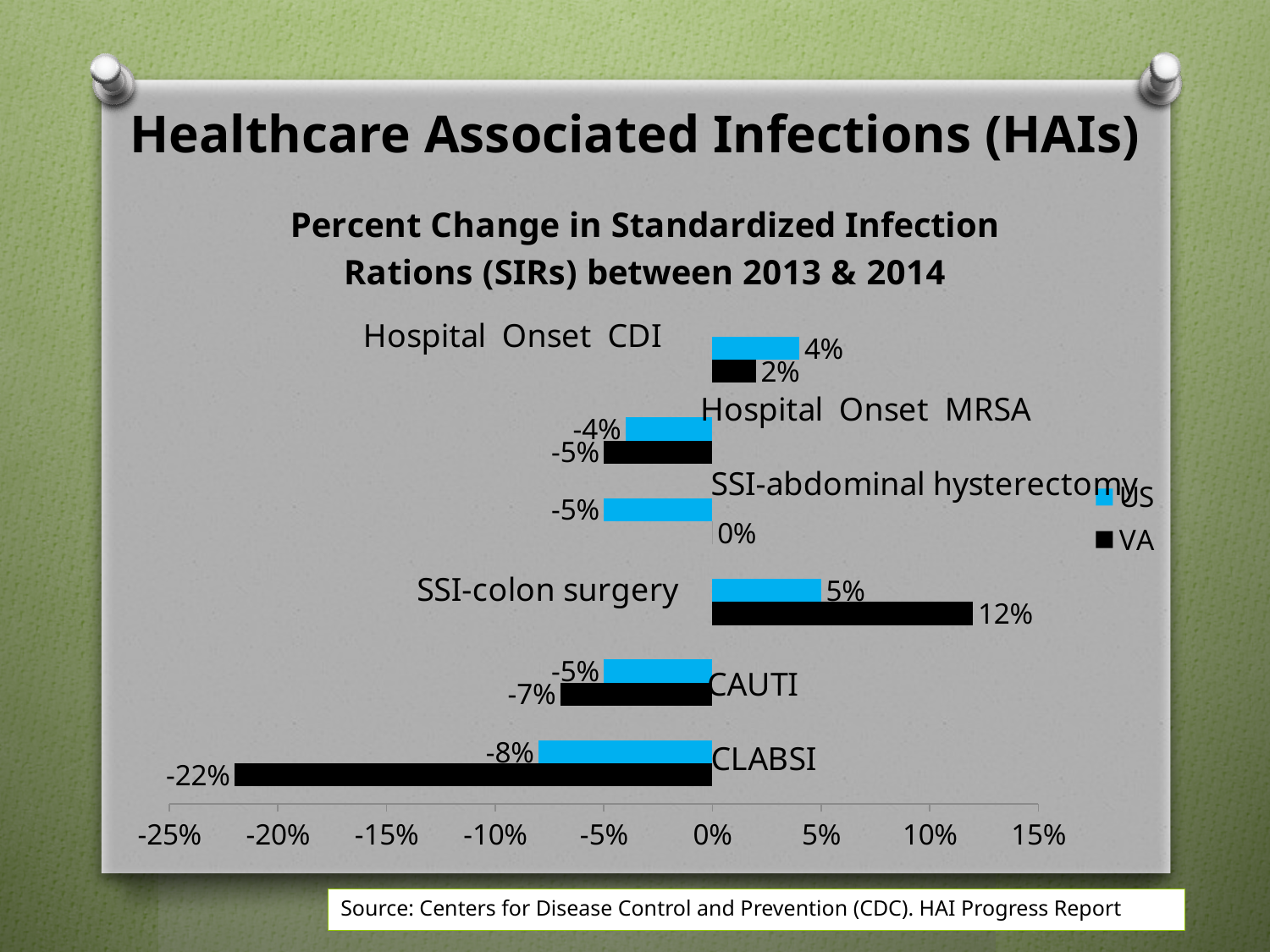
What is the US value for SSI-colon surgery? 5% How many infection categories are plotted in the chart? 6 What is the title of the chart? Percent Change in Standardized Infection Rations (SIRs) between 2013 & 2014 How many series does the legend list? 2 What kind of chart is shown on the slide? bar chart Which is larger for CAUTI, the US value or the VA value? US What is the VA value for CLABSI? -22% What is the VA value for SSI-abdominal hysterectomy? 0% Which category has the highest VA value? SSI-colon surgery Which category has the lowest VA value? CLABSI What is the difference between the VA and US values for SSI-colon surgery? 7% What is the US value for Hospital Onset CDI? 4%